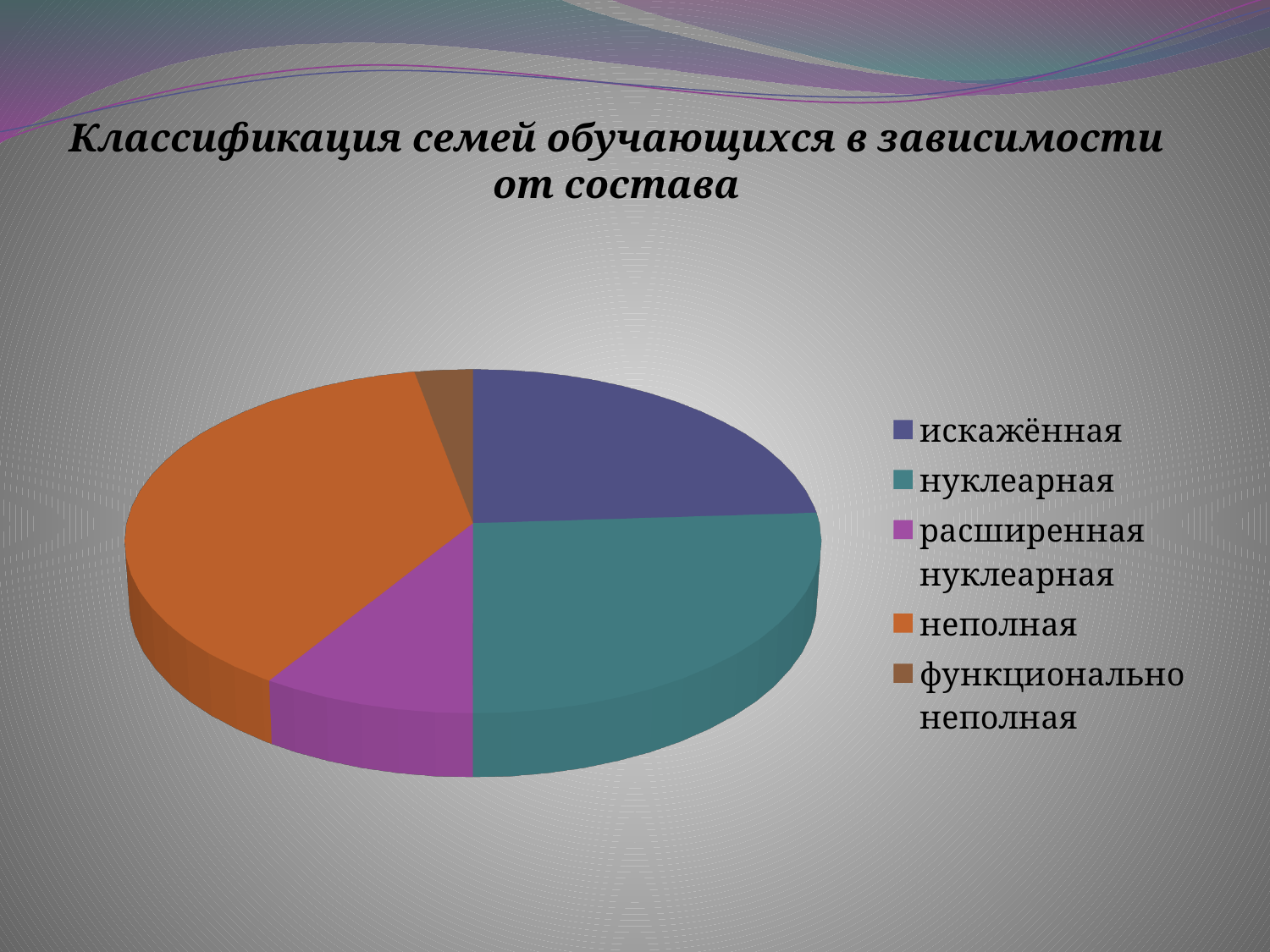
Which category has the largest slice of the pie? неполная Which slice is larger: расширенная нуклеарная or функционально неполная? расширенная нуклеарная Which category has the smallest slice of the pie? функционально неполная What is the title of the chart on the slide? Классификация семей обучающихся в зависимости от состава How many entries does the legend list? 5 Which slice is larger: неполная or расширенная нуклеарная? неполная What kind of chart is shown on the slide? pie chart What colour is the slice for неполная? orange How many categories does the pie chart show? 5 Which slice is larger: неполная or искажённая? неполная